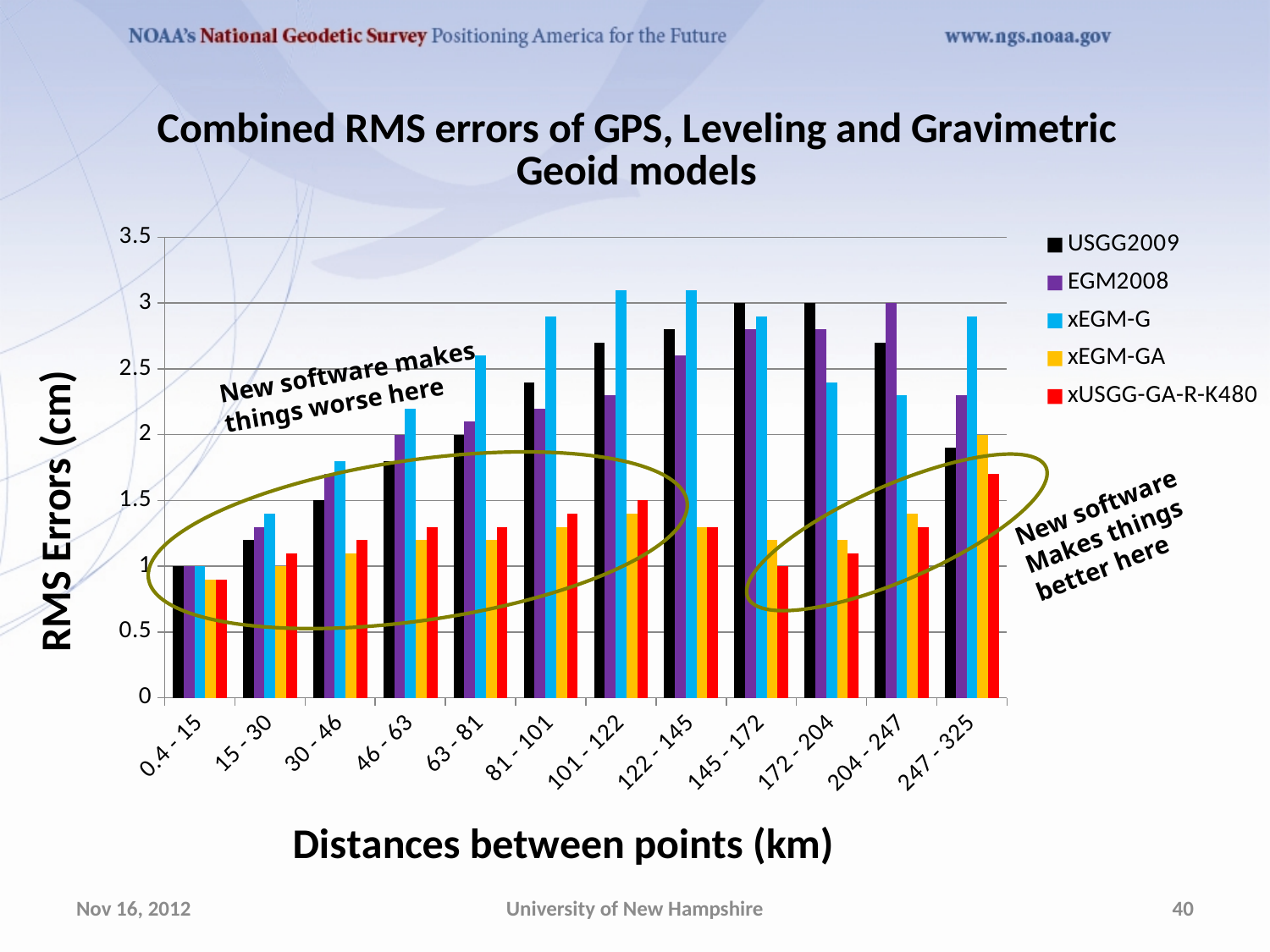
What kind of chart is shown on the slide? bar chart For which distance range is the EGM2008 RMS error highest? 204 - 247 How many distance categories are shown on the x axis? 12 Is the xEGM-G value for 46 - 63 km greater or less than 2? greater Which series has the lowest RMS error for the 145 - 172 km distance range? xUSGG-GA-R-K480 Does the USGG2009 RMS error rise or fall from 0.4 - 15 km to 145 - 172 km? rise What is the title of the chart? Combined RMS errors of GPS, Leveling and Gravimetric Geoid models Which series has the highest RMS error for the 101 - 122 km distance range? xEGM-G Is the xUSGG-GA-R-K480 value for 0.4 - 15 km greater or less than 1? less Is the xEGM-G value for 101 - 122 km greater or less than 3? greater For the 172 - 204 km range, which is larger: the USGG2009 value or the xEGM-G value? USGG2009 How many series does the legend list? 5